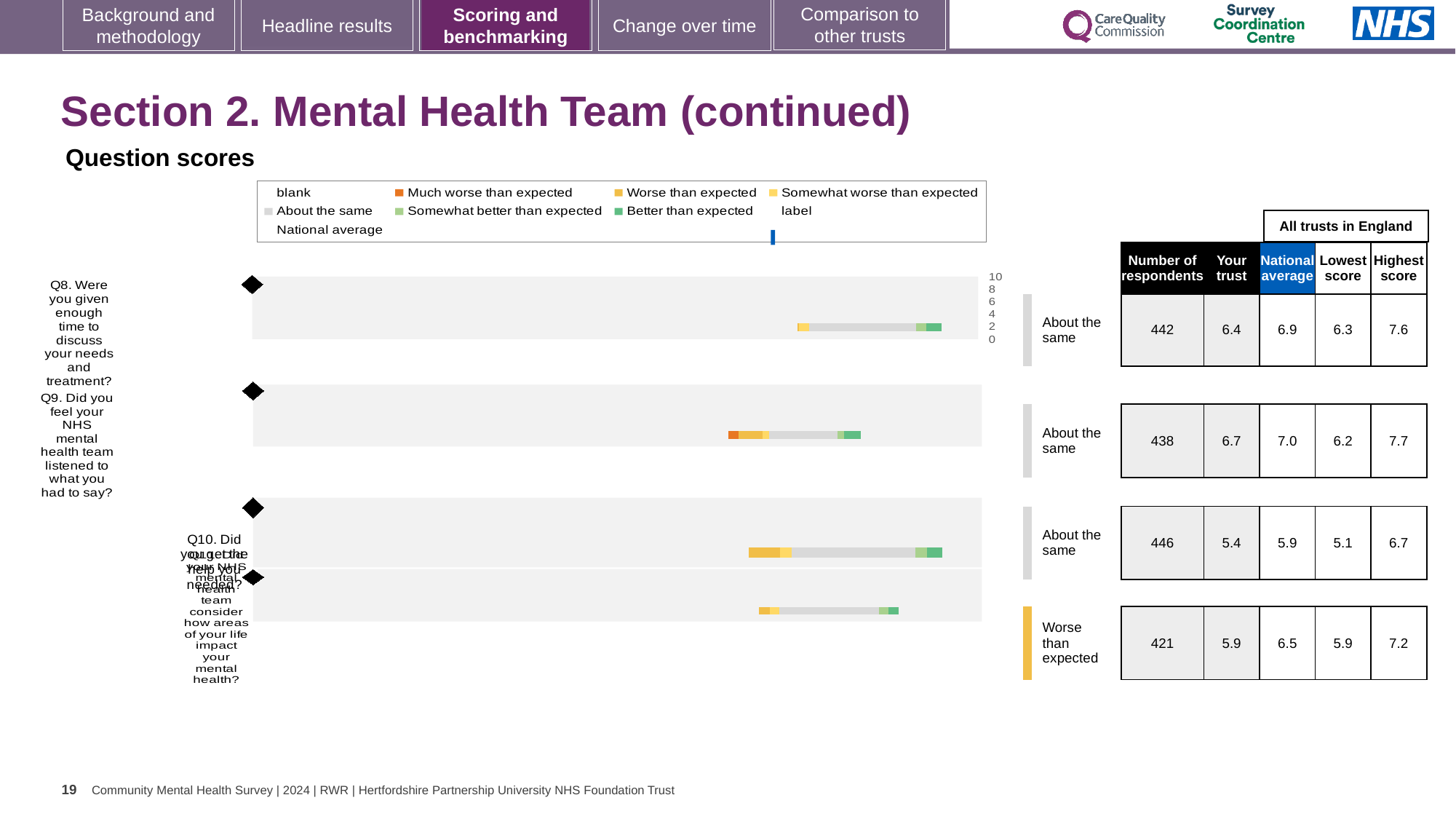
What is the national average score for Q10 (Did you get the help you needed?)? 5.9 What is the highest score among all trusts in England for the bottom question (about how areas of your life impact your mental health)? 7.2 Which question has the highest 'Your trust' score in the table? Q9 Which question row is rated 'Worse than expected' rather than 'About the same'? The bottom question (about how areas of your life impact your mental health) What is the lowest score among all trusts in England for Q10? 5.1 What type of chart is used to show the question scores on this slide? bar chart For Q8, what is the difference between the national average (6.9) and the trust's score (6.4)? 0.5 Which question has the lowest 'Your trust' score in the table? Q10 Which question had more respondents, Q8 or Q9? Q8 In the table beside the chart, how many respondents are listed for Q8 (Were you given enough time to discuss your needs and treatment?)? 442 How many questions (bars) are plotted in the question scores chart? 4 What is the 'Your trust' score for Q9 (Did you feel your NHS mental health team listened to what you had to say?)? 6.7